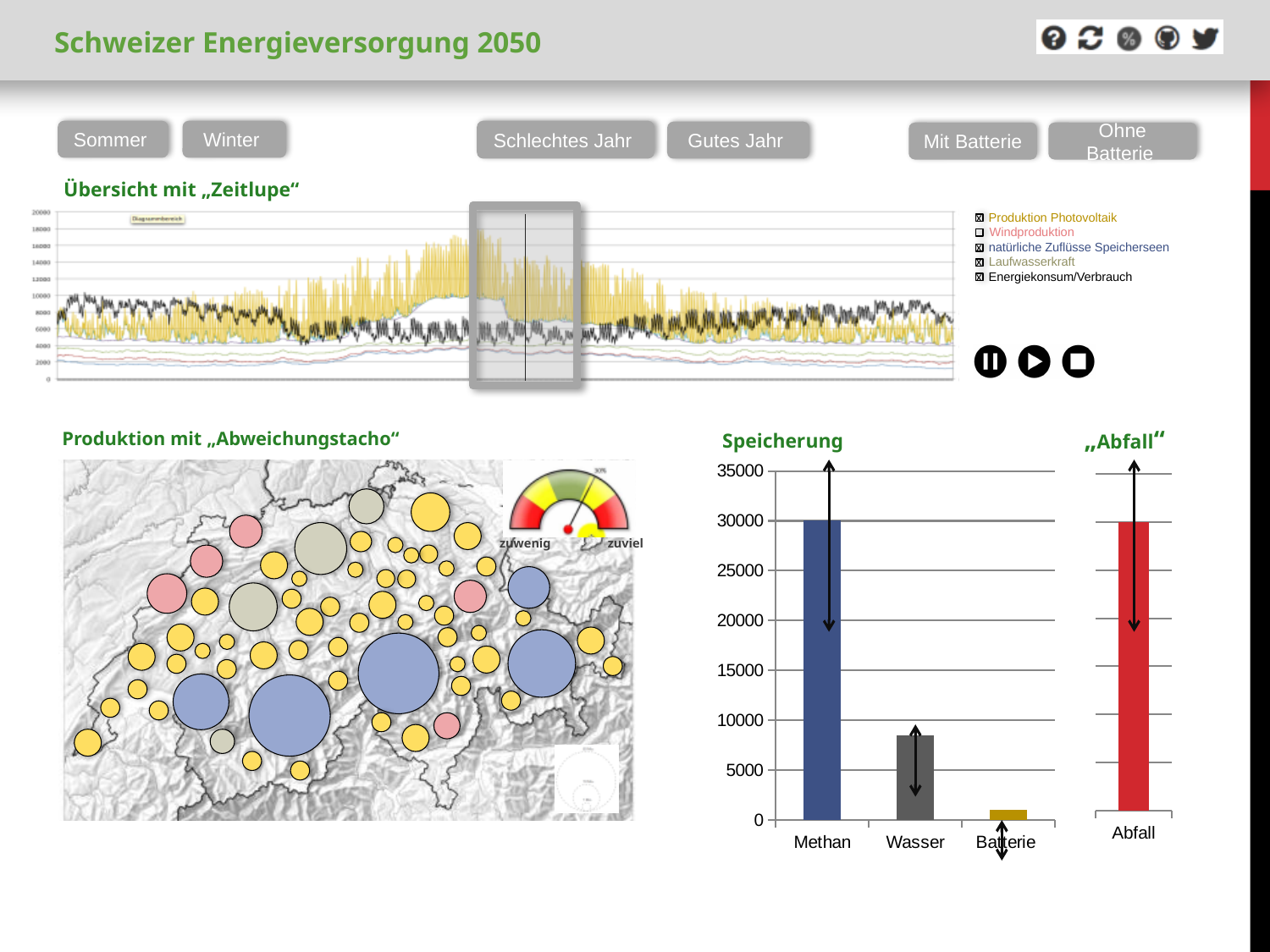
How many categories are shown in the "Speicherung" chart? 3 What is the highest value labelled on the y axis of the "Speicherung" chart? 35000 In the "Speicherung" chart, which category has the highest value? Methan In the "Speicherung" chart, is the value for Batterie greater or less than 5000? less In the "Speicherung" chart, is the value for Wasser greater or less than 5000? greater How many entries does the legend of the "Übersicht mit Zeitlupe" chart list? 5 What kind of chart is the "Speicherung" chart? bar chart How many bars are shown in the "Abfall" chart? 1 In the "Speicherung" chart, which is larger, Methan or Wasser? Methan In the "Speicherung" chart, which category has the lowest value? Batterie In the "Speicherung" chart, what is the value for Methan? 30000 In the "Speicherung" chart, is the value for Wasser greater or less than 10000? less